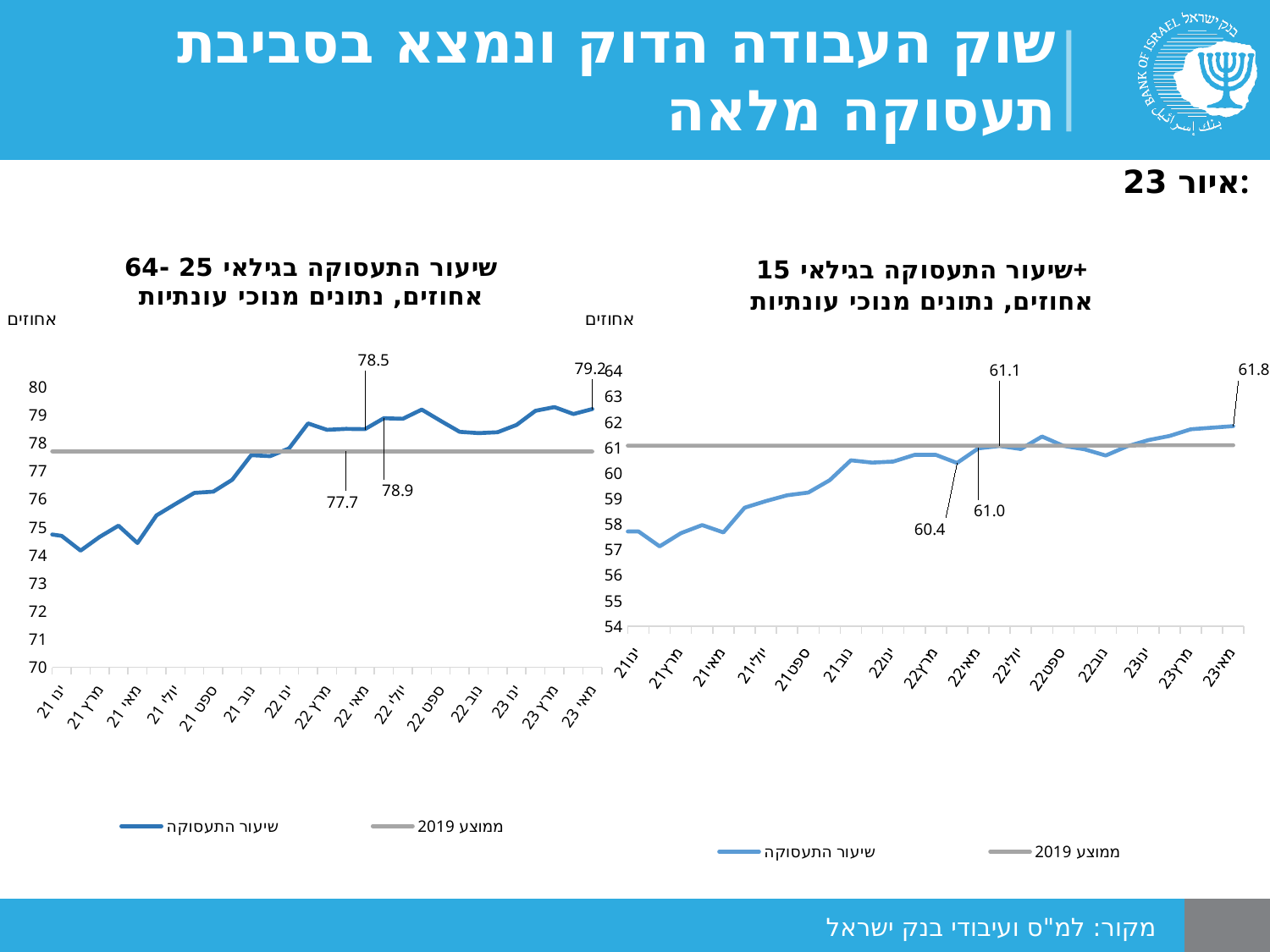
On the left chart (employment rate ages 25-64), what is the value of the last labelled point, at May 2023? 79.2 What type of chart is shown on the right side of the slide (employment rate ages 15+)? line chart On the left chart (employment rate ages 25-64), is the value at January 2021 greater or less than 76? less On the right chart (employment rate ages 15+), does the employment rate generally rise or fall from January 2021 to May 2023? rise On the right chart (employment rate ages 15+), what is the value of the last labelled point, at May 2023? 61.8 On the right chart (employment rate ages 15+), what is the lowest labelled value shown? 60.4 On the right chart (employment rate ages 15+), is the value at January 2021 greater or less than 60? less How many series does the legend of the right chart (employment rate ages 15+) list? 2 On the left chart (employment rate ages 25-64), what is the highest labelled value shown? 79.2 On the right chart (employment rate ages 15+), what is the difference between the labelled values 61.8 and 61.0? 0.8 On the left chart (employment rate ages 25-64), which labelled value is larger: 78.9 or 78.5? 78.9 On the left chart (employment rate ages 25-64), what is the difference between the labelled values 78.5 and 77.7? 0.8